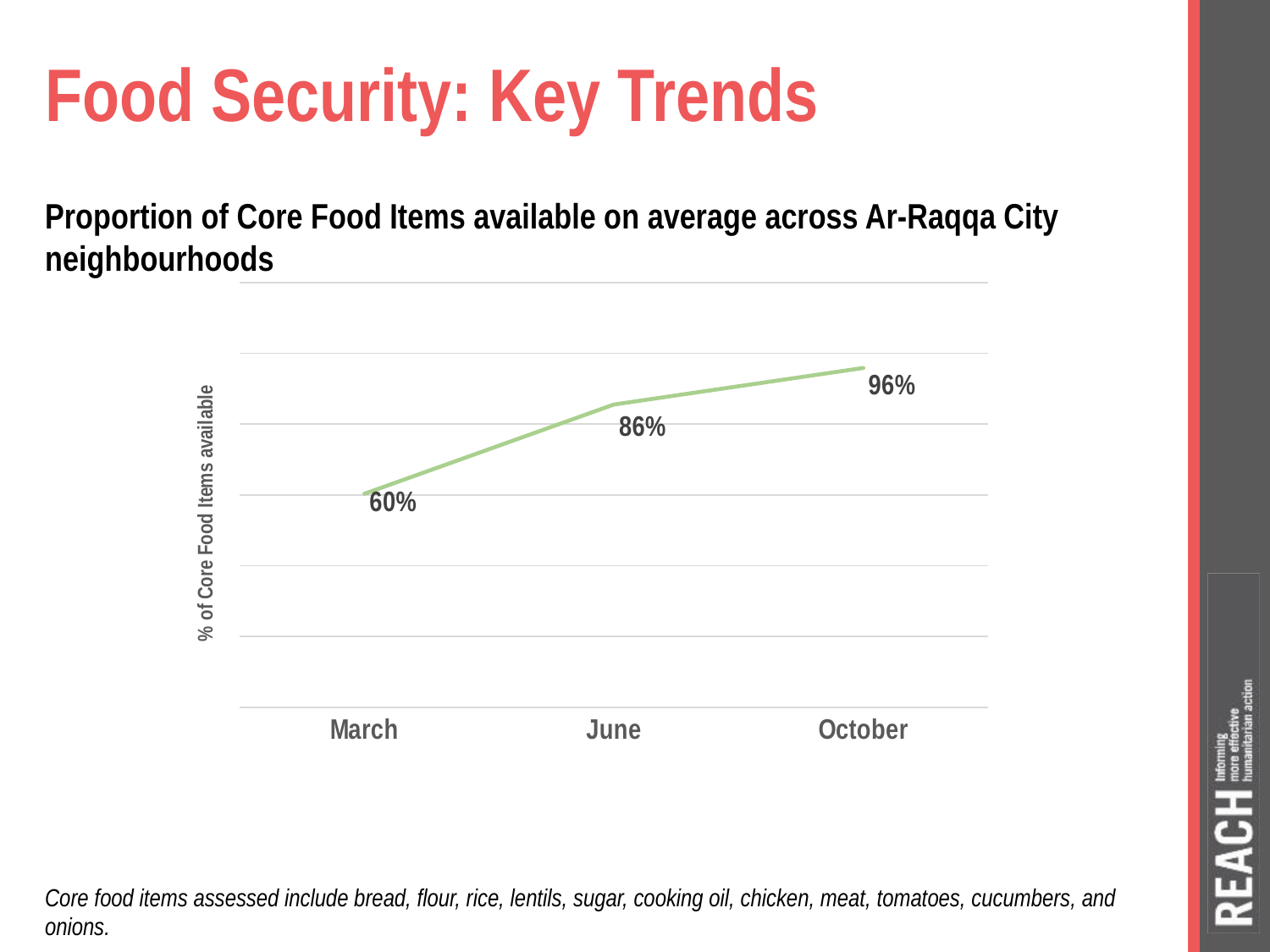
Which month has the lowest proportion of core food items available? March Which is larger, the value for June or the value for October? October Which month has the highest proportion of core food items available? October What is the label of the vertical axis? % of Core Food Items available How many months are plotted on the chart? 3 Do the values rise or fall from March to October? Rise What percentage of core food items was available in October? 96% What is the difference in percentage points between June and March? 26 What kind of chart is shown on the slide? Line chart What percentage of core food items was available in June? 86% What percentage of core food items was available in March? 60% What is the difference in percentage points between October and March? 36